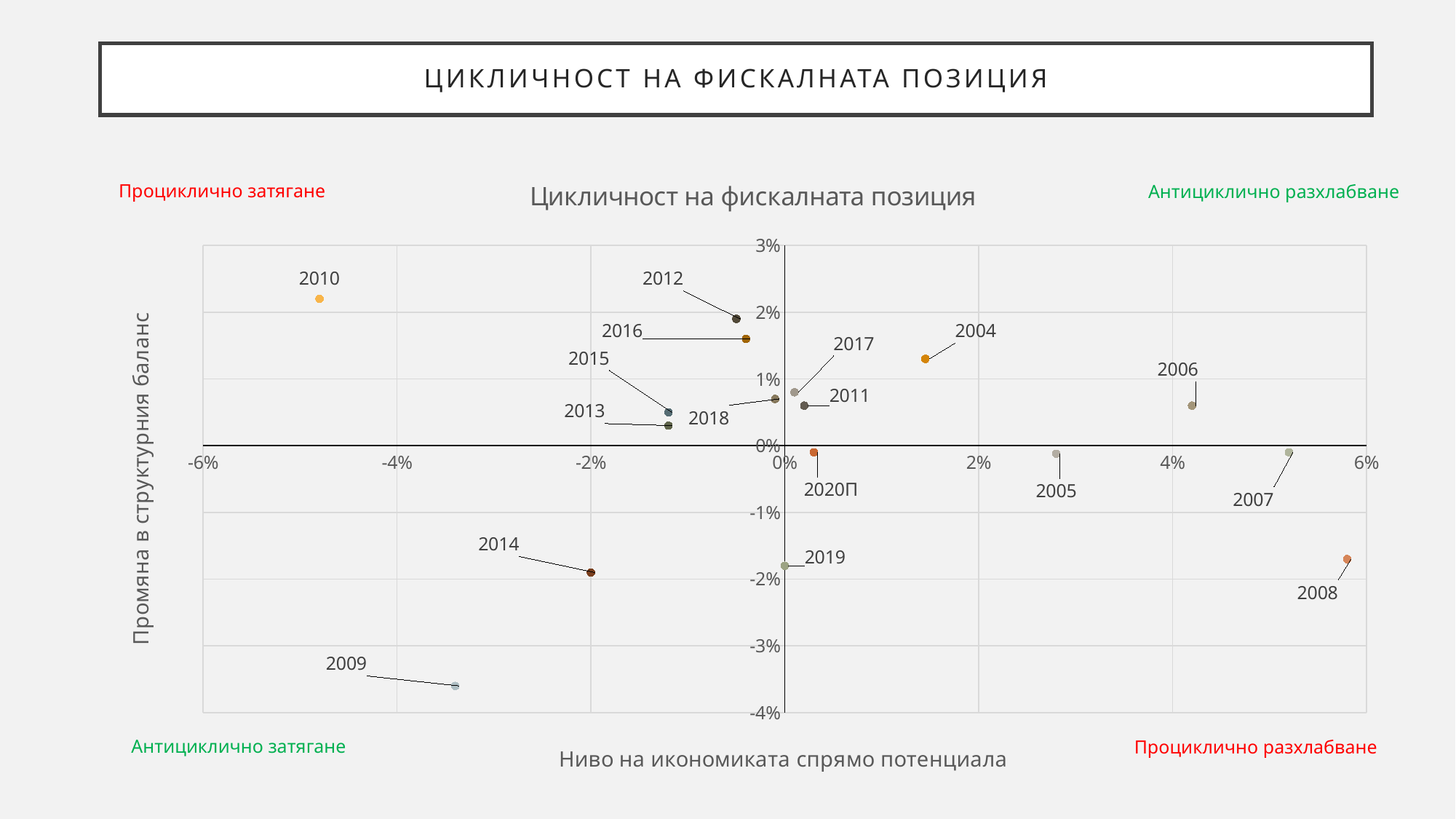
What is the title of the chart? Цикличност на фискалната позиция What kind of chart is shown on the slide? scatter chart Is the vertical-axis value for 2012 greater or less than 1%? greater Which year has the lowest value on the vertical axis (Промяна в структурния баланс)? 2009 Which year has the higher vertical-axis value, 2010 or 2009? 2010 Is the vertical-axis value for 2009 greater or less than -3%? less Is the vertical-axis value for 2014 greater or less than -1%? less Which year is plotted furthest to the right on the horizontal axis (Ниво на икономиката спрямо потенциала)? 2008 Which year has the highest value on the vertical axis (Промяна в структурния баланс)? 2010 What is the label of the horizontal axis? Ниво на икономиката спрямо потенциала How many data points (years) are plotted on the chart? 17